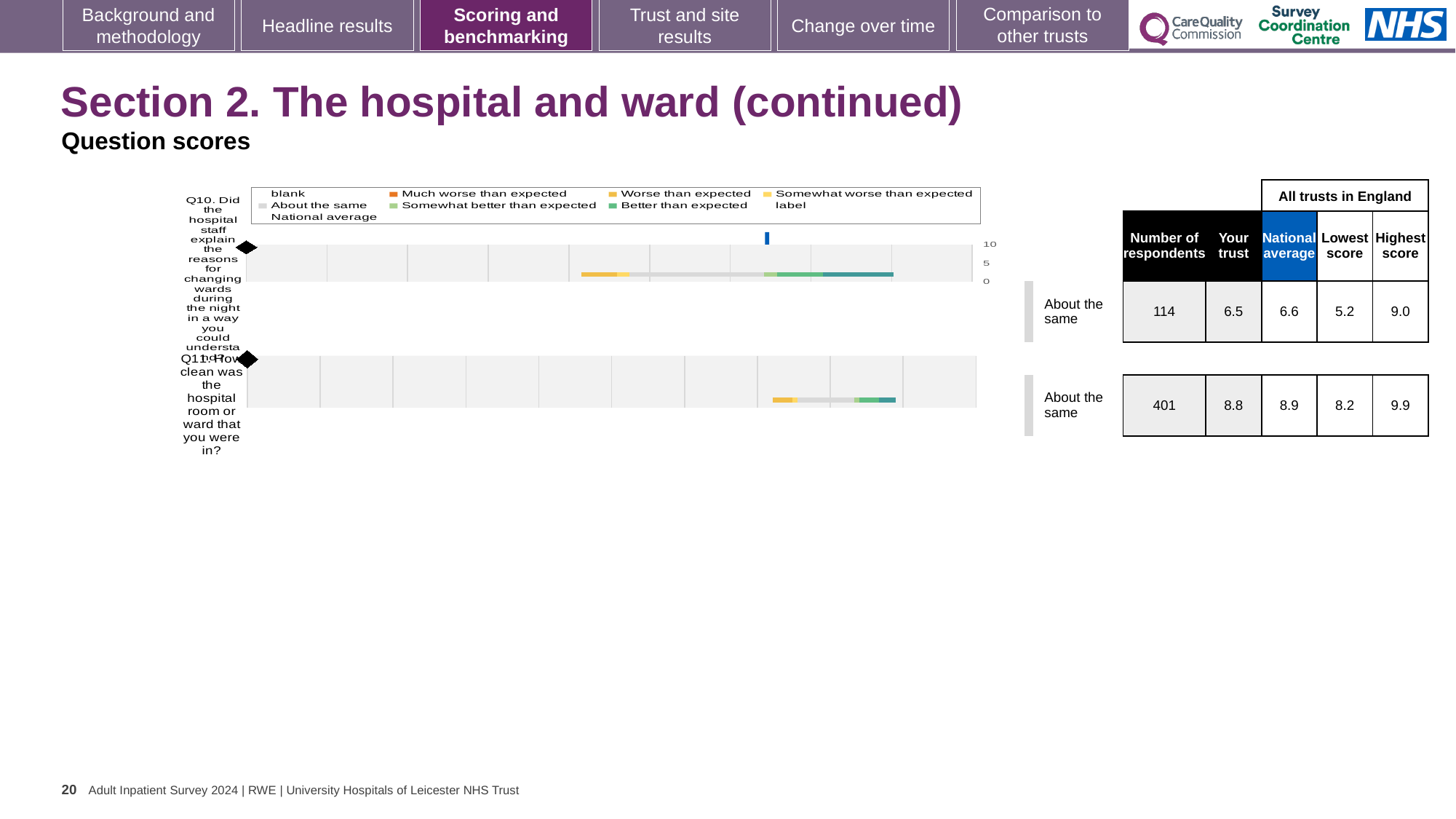
By how much does the national average for Q11 exceed the trust's score for Q11? 0.1 What is the 'Your trust' score for Q11 (How clean was the hospital room or ward that you were in?)? 8.8 What is the highest score among all trusts in England for Q10? 9.0 How many questions are plotted on the chart? 2 Is the trust's score for Q11 greater or less than 5? greater What is the national average score for Q10 (Did the hospital staff explain the reasons for changing wards during the night in a way you could understand?)? 6.6 What type of chart is used to show the question scores? Bar chart What is the lowest score among all trusts in England for Q11? 8.2 What is the difference between the highest and lowest scores for Q10 across all trusts in England? 3.8 How many respondents answered Q11 (How clean was the hospital room or ward)? 401 Which question has the higher 'Your trust' score, Q10 or Q11? Q11 What benchmark category is shown for both Q10 and Q11? About the same